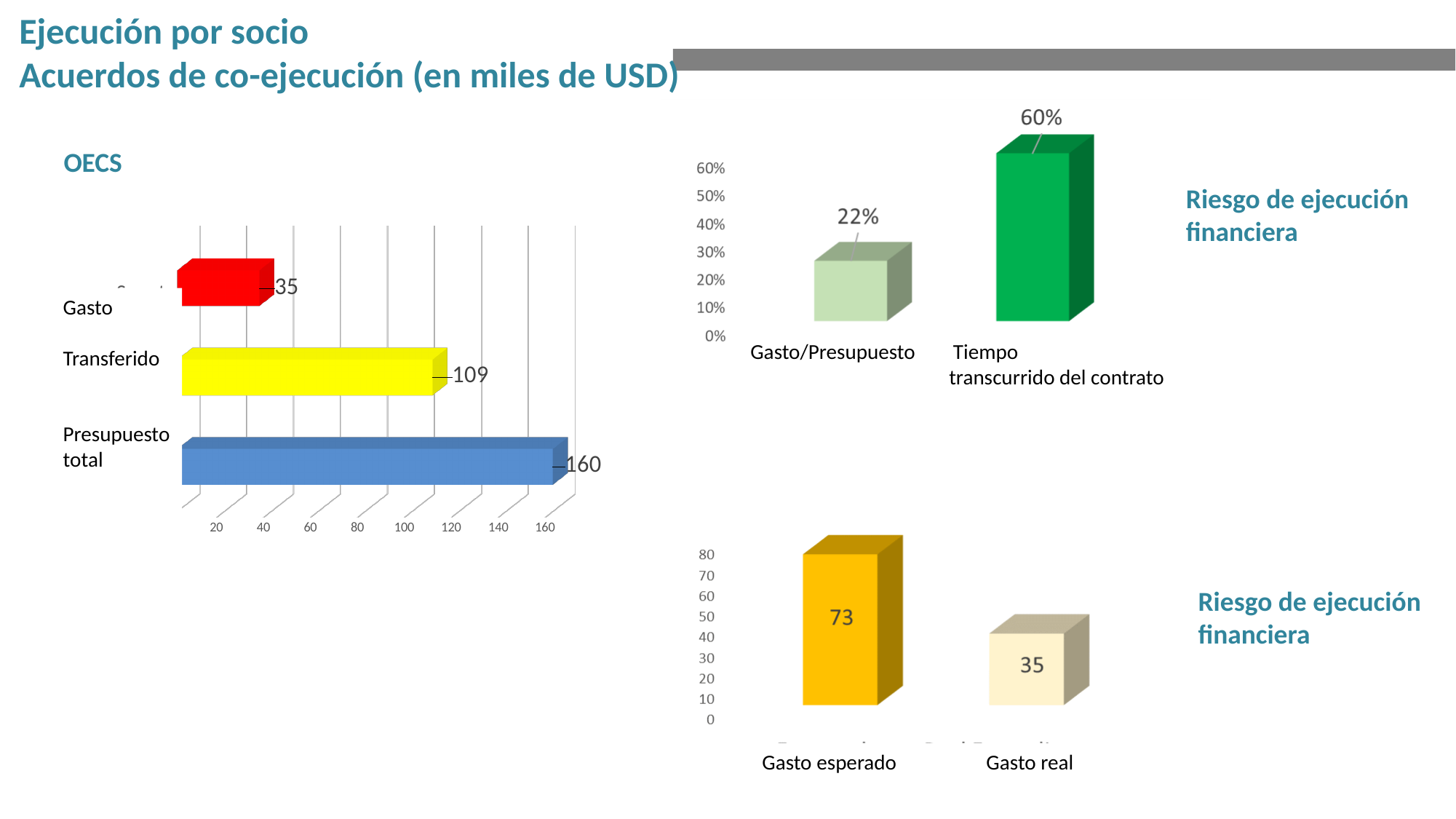
In the OECS chart on the left, what is the value for Transferido? 109 In the OECS chart on the left, what is the value for Presupuesto total? 160 In the OECS chart on the left, what is the value for Gasto? 35 In the OECS chart on the left, which category has the lowest value? Gasto In the top-right chart, what is the value for Gasto/Presupuesto? 22% In the top-right chart, which is larger, Gasto/Presupuesto or Tiempo transcurrido del contrato? Tiempo transcurrido del contrato In the bottom-right chart, what is the value for Gasto esperado? 73 What kind of chart is the OECS chart on the left? Bar chart In the OECS chart on the left, how many categories are plotted? 3 In the top-right chart, what is the value for Tiempo transcurrido del contrato? 60% In the OECS chart on the left, what is the difference between Presupuesto total and Transferido? 51 In the bottom-right chart, what is the difference between Gasto esperado and Gasto real? 38